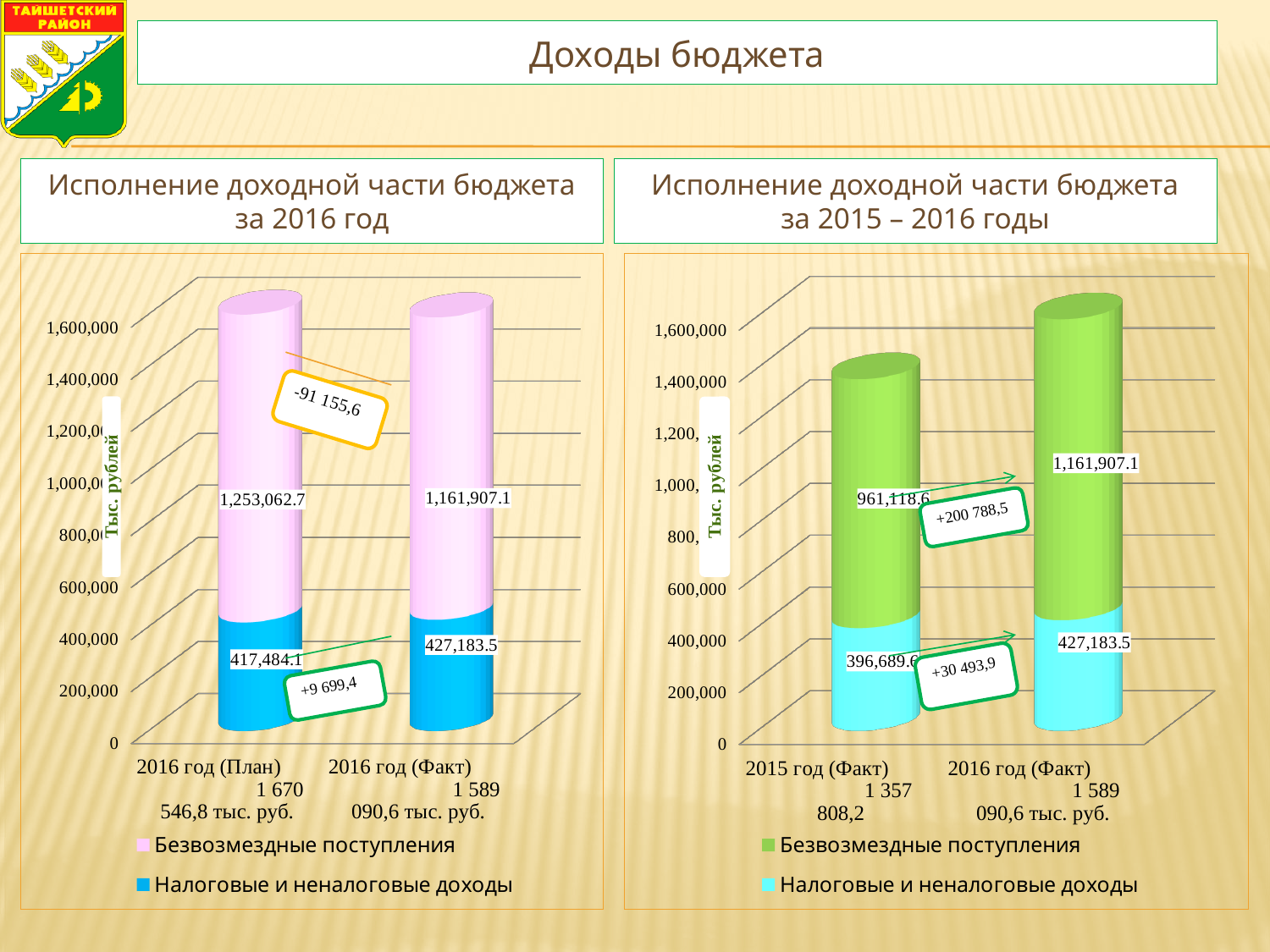
In the left chart (за 2016 год), what is the value of Безвозмездные поступления for 2016 год (План)? 1,253,062.7 What is the y-axis label of the left chart (за 2016 год)? Тыс. рублей In the right chart (за 2015 – 2016 годы), what is the difference in Налоговые и неналоговые доходы between 2016 год (Факт) and 2015 год (Факт)? 30,493.9 In the left chart (за 2016 год), by how much does Безвозмездные поступления for 2016 год (План) exceed that for 2016 год (Факт)? 91,155.6 In the right chart (за 2015 – 2016 годы), what is the value of Налоговые и неналоговые доходы for 2015 год (Факт)? 396,689.6 In the right chart (за 2015 – 2016 годы), what is the difference in Безвозмездные поступления between 2016 год (Факт) and 2015 год (Факт)? 200,788.5 In the right chart (за 2015 – 2016 годы), which year has the higher value of Безвозмездные поступления? 2016 год (Факт) What kind of chart is the right chart (за 2015 – 2016 годы)? Stacked bar chart In the right chart (за 2015 – 2016 годы), what is the value of Безвозмездные поступления for 2015 год (Факт)? 961,118.6 In the left chart (за 2016 год), what is the value of Налоговые и неналоговые доходы for 2016 год (Факт)? 427,183.5 How many series does the legend of the left chart (за 2016 год) list? 2 In the left chart (за 2016 год), which is larger: Налоговые и неналоговые доходы for 2016 год (План) or for 2016 год (Факт)? 2016 год (Факт)